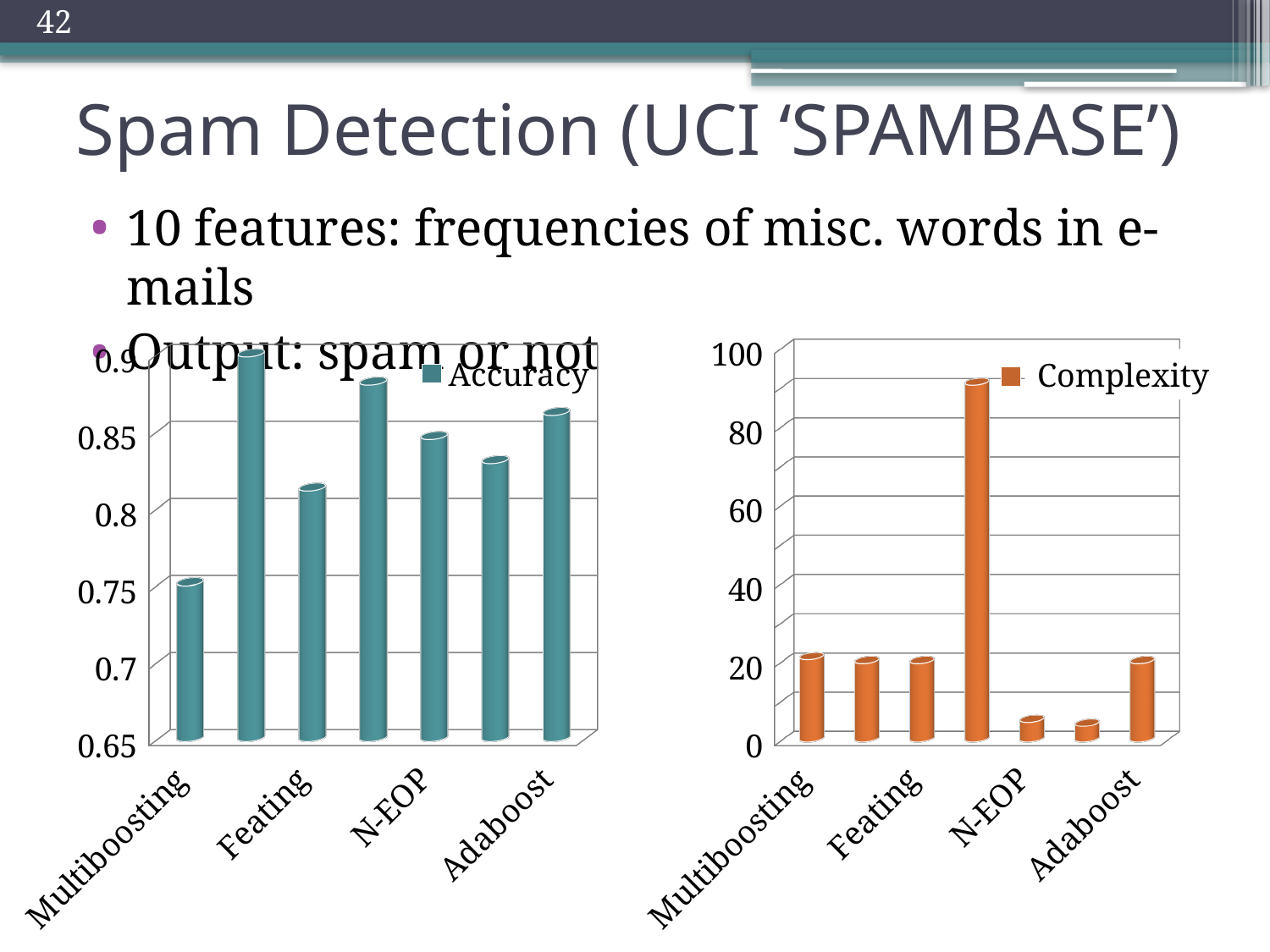
In the Complexity chart, is the value for Adaboost greater or less than 40? less In the Accuracy chart, is the value for Feating greater or less than 0.8? greater What is the legend entry of the chart on the right? Complexity How many bars are plotted in the Complexity chart on the right? 7 What kind of chart is the Accuracy chart on the left? bar chart In the Accuracy chart, is the value for Multiboosting greater or less than 0.8? less In the Complexity chart, which has the higher value, Multiboosting or N-EOP? Multiboosting How many series does the legend of the Accuracy chart list? 1 In the Accuracy chart, which has the higher value, Adaboost or Multiboosting? Adaboost In the Accuracy chart, which labeled method has the lowest accuracy? Multiboosting